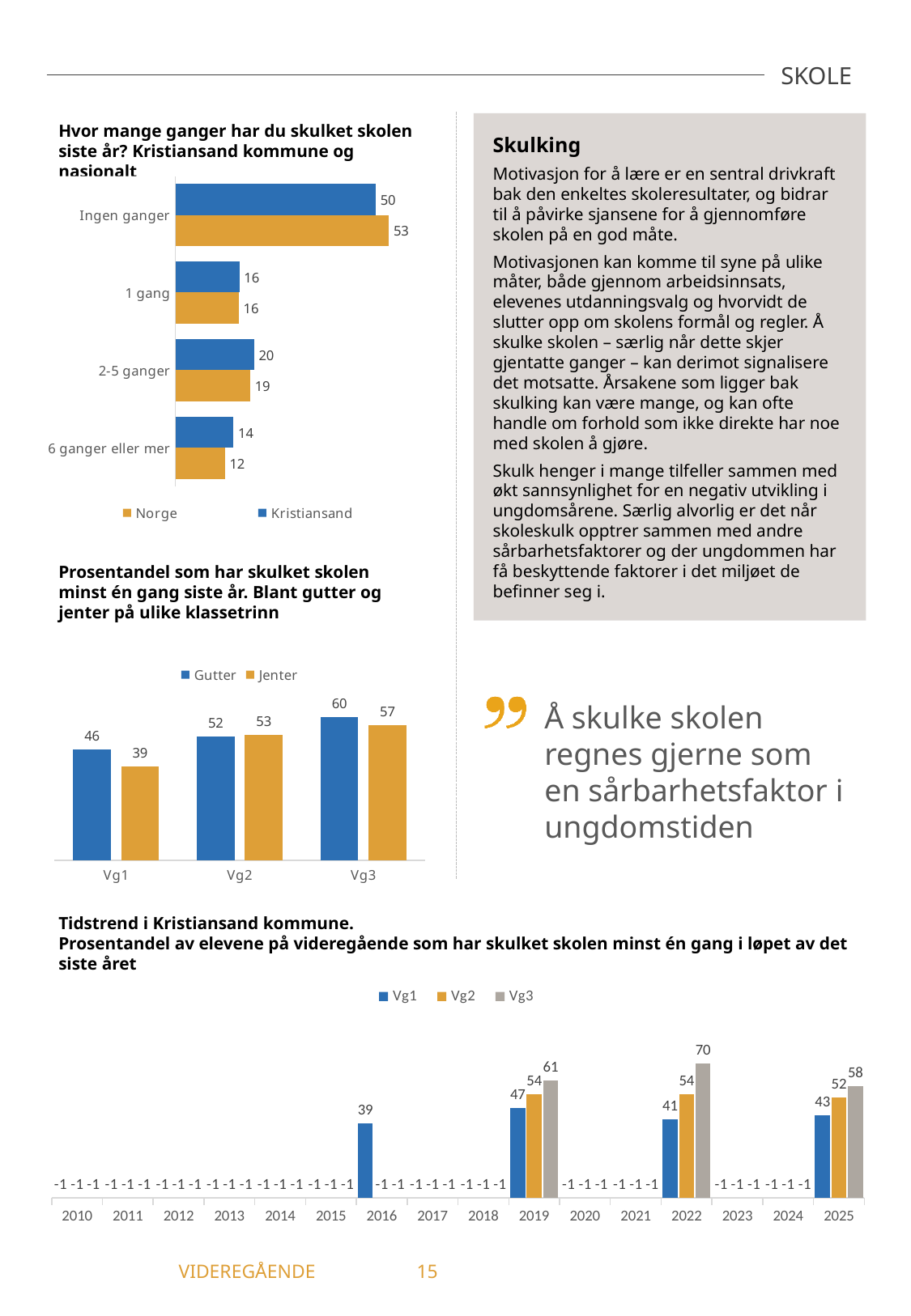
In the middle-left chart 'Prosentandel som har skulket skolen minst én gang siste år', which is larger at Vg3: Gutter or Jenter? Gutter In the top-left chart 'Hvor mange ganger har du skulket skolen siste år?', what is the difference between Kristiansand and Norge for '6 ganger eller mer'? 2 In the middle-left chart 'Prosentandel som har skulket skolen minst én gang siste år', what is the difference between Gutter and Jenter at Vg1? 7 In the top-left chart 'Hvor mange ganger har du skulket skolen siste år?', what is the value for Kristiansand in the '2-5 ganger' category? 20 In the middle-left chart 'Prosentandel som har skulket skolen minst én gang siste år', do the values for Gutter rise or fall from Vg1 to Vg3? rise In the bottom chart 'Tidstrend i Kristiansand kommune', what is the value for Vg1 in 2016? 39 What kind of chart is the bottom chart 'Tidstrend i Kristiansand kommune'? bar chart In the top-left chart 'Hvor mange ganger har du skulket skolen siste år?', which category has the highest value for Kristiansand? Ingen ganger In the top-left chart 'Hvor mange ganger har du skulket skolen siste år?', what is the value for Norge in the 'Ingen ganger' category? 53 In the top-left chart 'Hvor mange ganger har du skulket skolen siste år?', how many series does the legend list? 2 In the bottom chart 'Tidstrend i Kristiansand kommune', what is the value for Vg3 in 2022? 70 In the middle-left chart 'Prosentandel som har skulket skolen minst én gang siste år', what is the value for Jenter at Vg1? 39